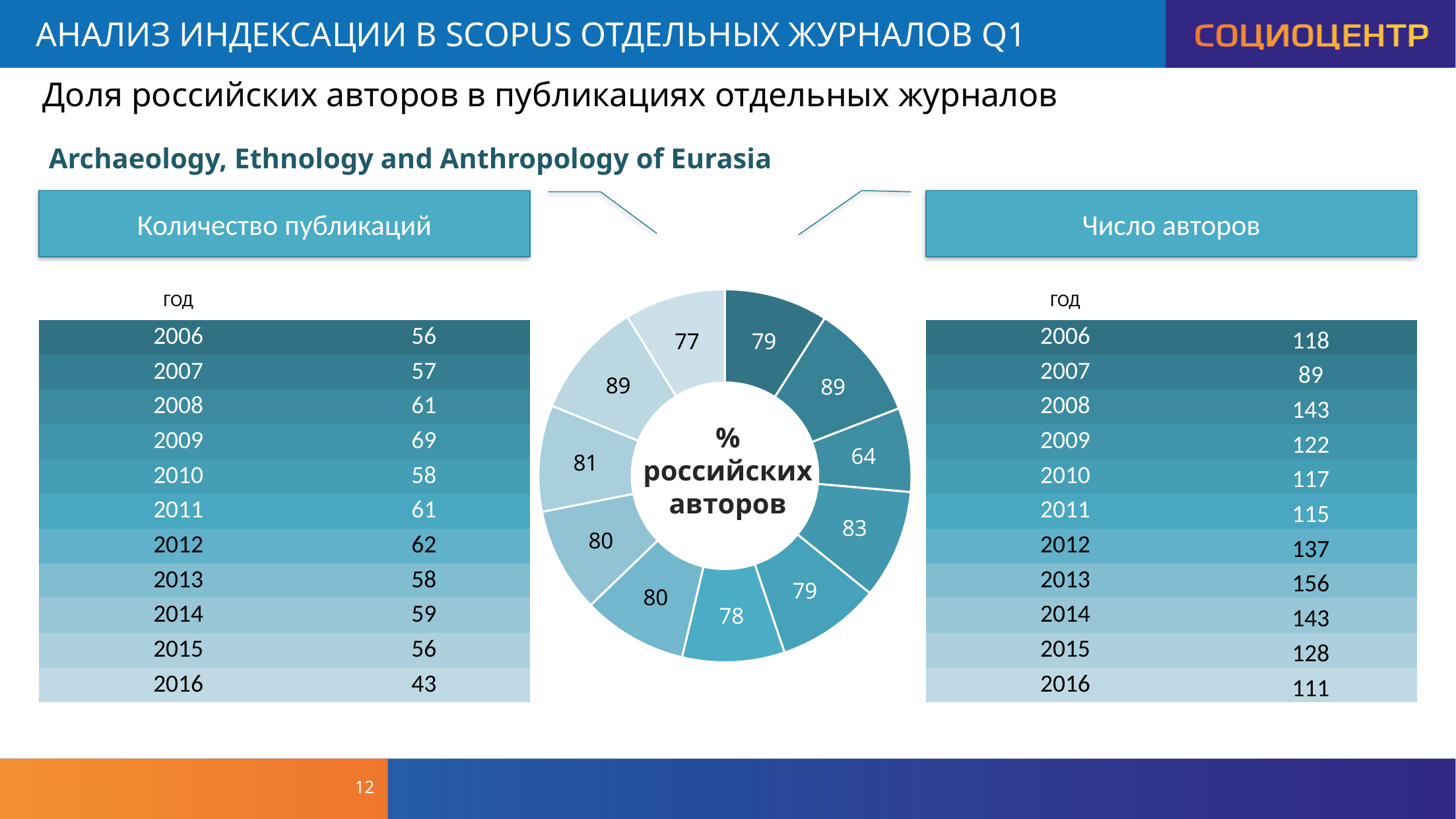
What text is written in the centre of the doughnut chart? % российских авторов What kind of chart is shown in the centre of the slide? Doughnut chart What value is labelled on the lightest slice at the top-left of the doughnut chart? 77 What is the highest value labelled on the doughnut chart? 89 Which journal is named above the doughnut chart? Archaeology, Ethnology and Anthropology of Eurasia What is the difference between the highest (89) and lowest (64) values on the doughnut chart? 25 What value is labelled on the darkest slice at the top of the doughnut chart? 79 How many slices does the doughnut chart have? 11 Is the lowest value on the doughnut chart greater or less than 70? less How many slices of the doughnut chart are labelled 89? 2 How many slices of the doughnut chart are labelled 80? 2 What is the lowest value labelled on the doughnut chart? 64